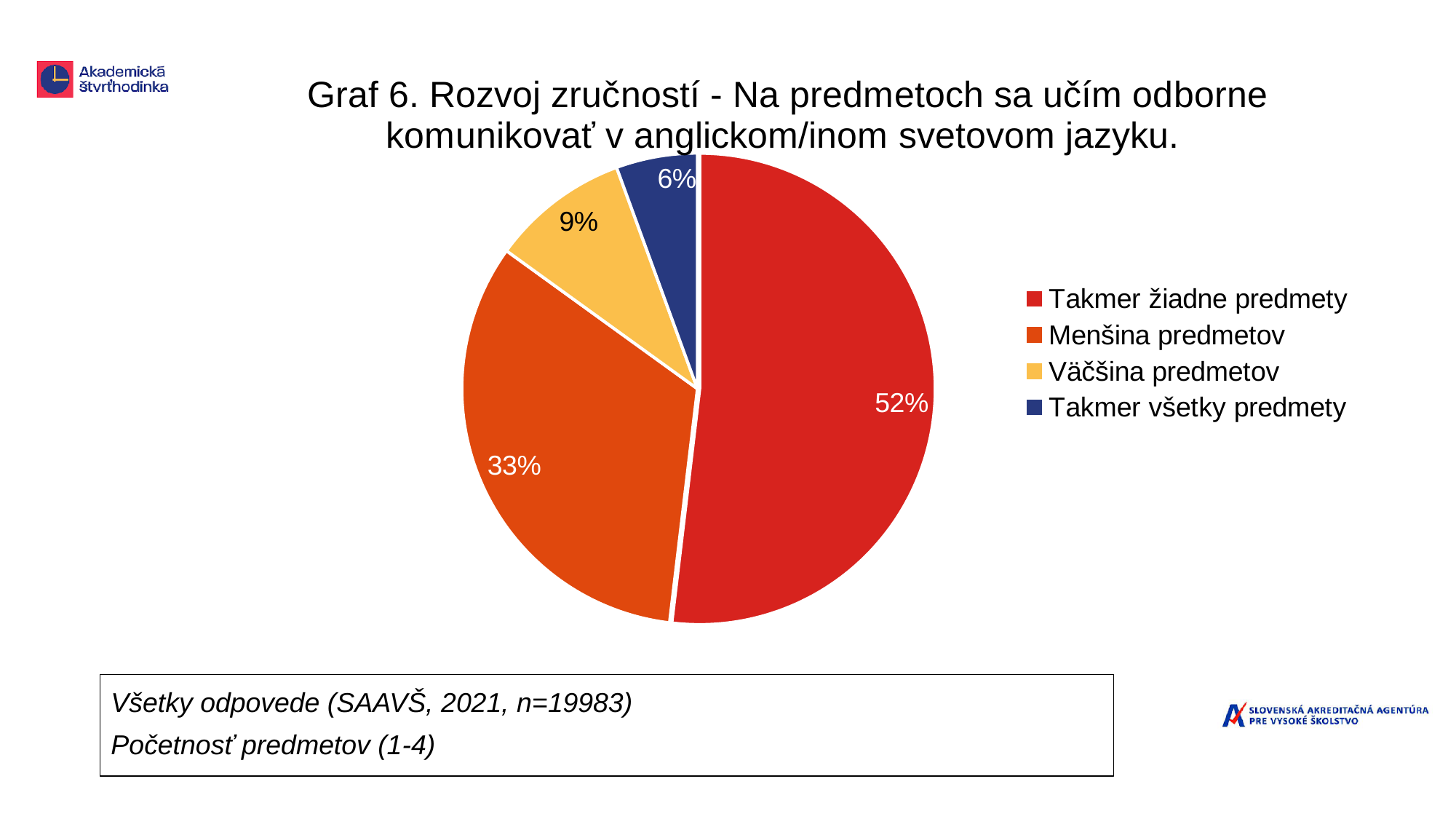
What kind of chart is shown on the slide? Pie chart What percentage of the pie is labelled "Takmer všetky predmety"? 6% What percentage of the pie is labelled "Menšina predmetov"? 33% What percentage of the pie is labelled "Takmer žiadne predmety"? 52% What is the difference in percentage points between "Takmer žiadne predmety" and "Menšina predmetov"? 19 How many slices does the pie chart have? 4 Which category has the smallest share of the pie? Takmer všetky predmety What colour is the slice for "Menšina predmetov"? Orange Which category has the largest share of the pie? Takmer žiadne predmety Which is larger, the share for "Väčšina predmetov" or the share for "Takmer všetky predmety"? Väčšina predmetov What percentage of the pie is labelled "Väčšina predmetov"? 9% How many entries does the legend list? 4